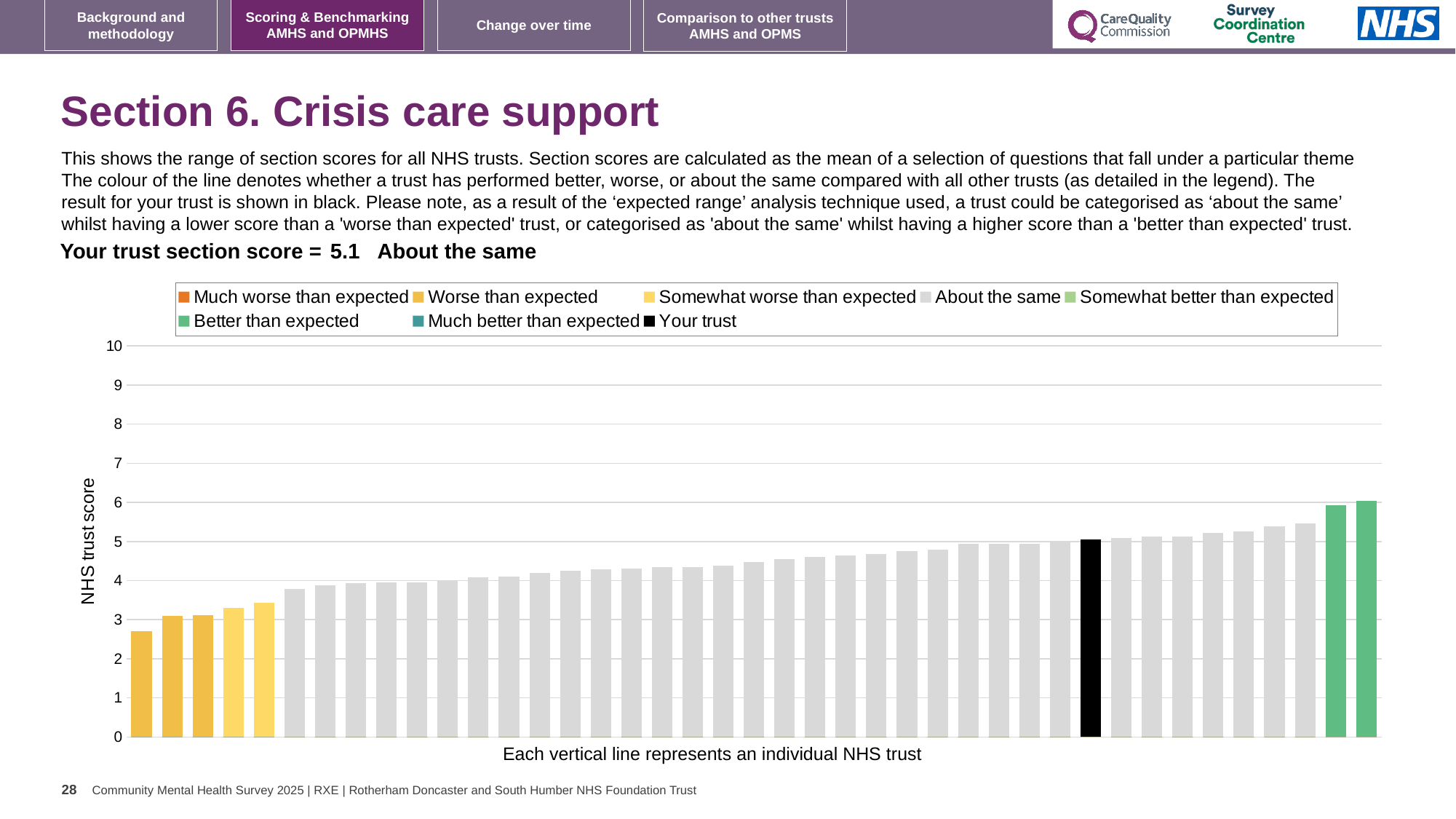
What kind of chart is shown on the slide? bar chart What is the label on the vertical axis of the chart? NHS trust score Is the value of the lowest bar in the chart greater or less than 3? less Is the score for your trust (the black bar) greater or less than 5? greater What does each vertical line in the chart represent, according to the x-axis label? An individual NHS trust Do the bar values rise or fall from left to right across the chart? rise How many entries does the chart legend list? 8 How many bars are coloured green for 'Better than expected'? 2 What is the section score for your trust shown on the slide? 5.1 Which legend category does the highest bar in the chart belong to? Better than expected Is the value of the highest bar in the chart greater or less than 5? greater Which performance category is your trust placed in for crisis care support? About the same